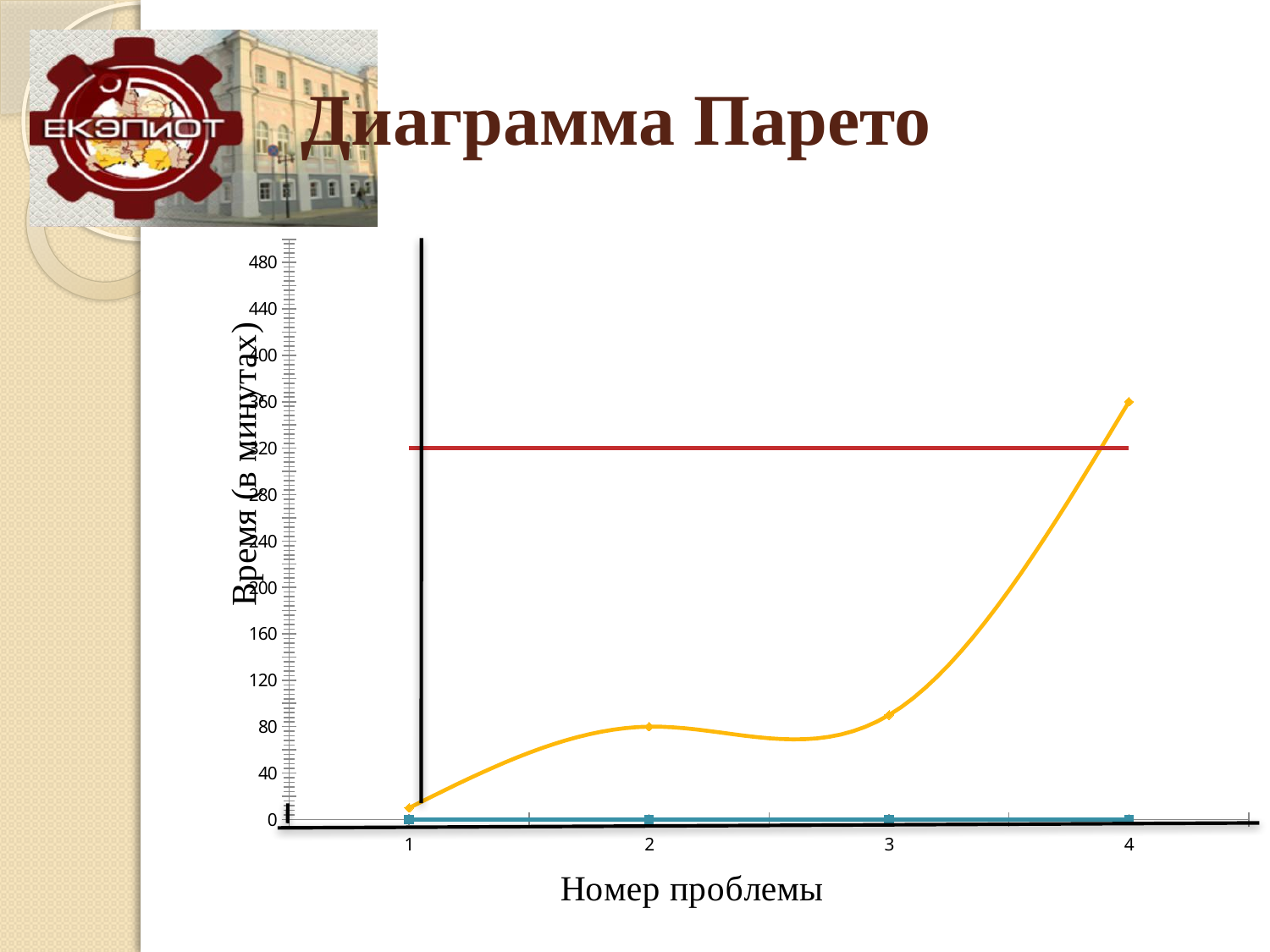
What kind of chart is shown on the slide? line chart Does the orange line rise or fall from problem 3 to problem 4? rise How many problem numbers are shown along the x axis? 4 Which has a larger value on the orange line, problem 2 or problem 4? problem 4 Is the value of the orange line for problem 1 greater or less than 40? less Is the value of the orange line for problem 3 greater or less than 120? less Which problem number has the highest value on the orange line? 4 At what value on the y axis is the horizontal red line drawn? 320 Which problem number has the lowest value on the orange line? 1 What is the title of the chart on the slide? Диаграмма Парето What is the label of the x axis of the chart? Номер проблемы Is the value of the orange line for problem 4 greater or less than 320? greater